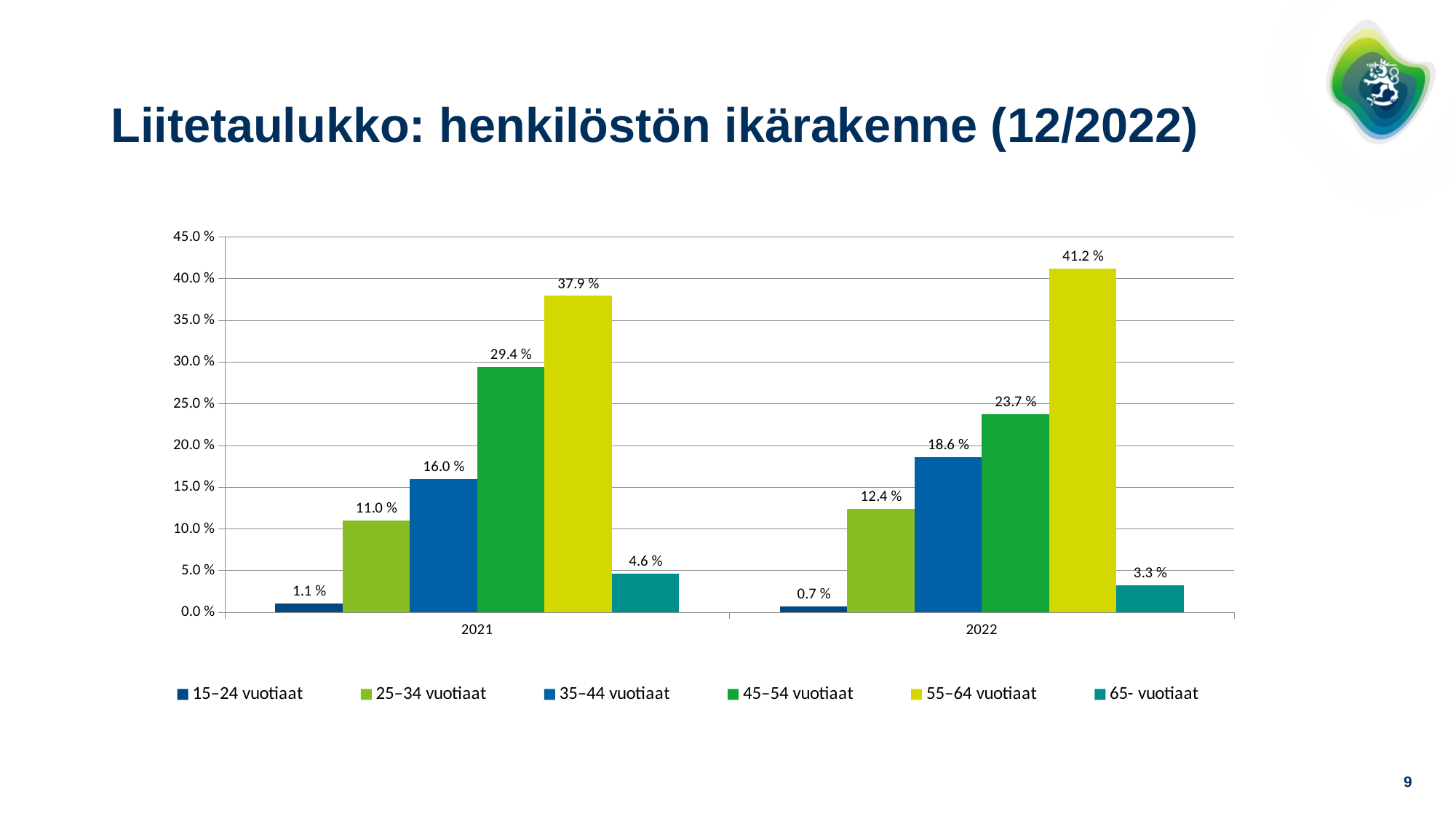
Which is larger: 45–54 vuotiaat in 2021 or 45–54 vuotiaat in 2022? 2021 Is the value for 25–34 vuotiaat in 2022 greater or less than 10.0 %? greater How many series does the legend list? 6 Which age group has the highest value in 2021? 55–64 vuotiaat How many year categories are shown on the x axis? 2 What is the value for 15–24 vuotiaat in 2021? 1.1 % Does the value for 65- vuotiaat rise or fall from 2021 to 2022? Fall What is the difference between the 55–64 vuotiaat values for 2022 and 2021? 3.3 % What is the value for 55–64 vuotiaat in 2022? 41.2 % Which age group has the lowest value in 2022? 15–24 vuotiaat What kind of chart is shown on the slide? Bar chart What is the value for 35–44 vuotiaat in 2022? 18.6 %